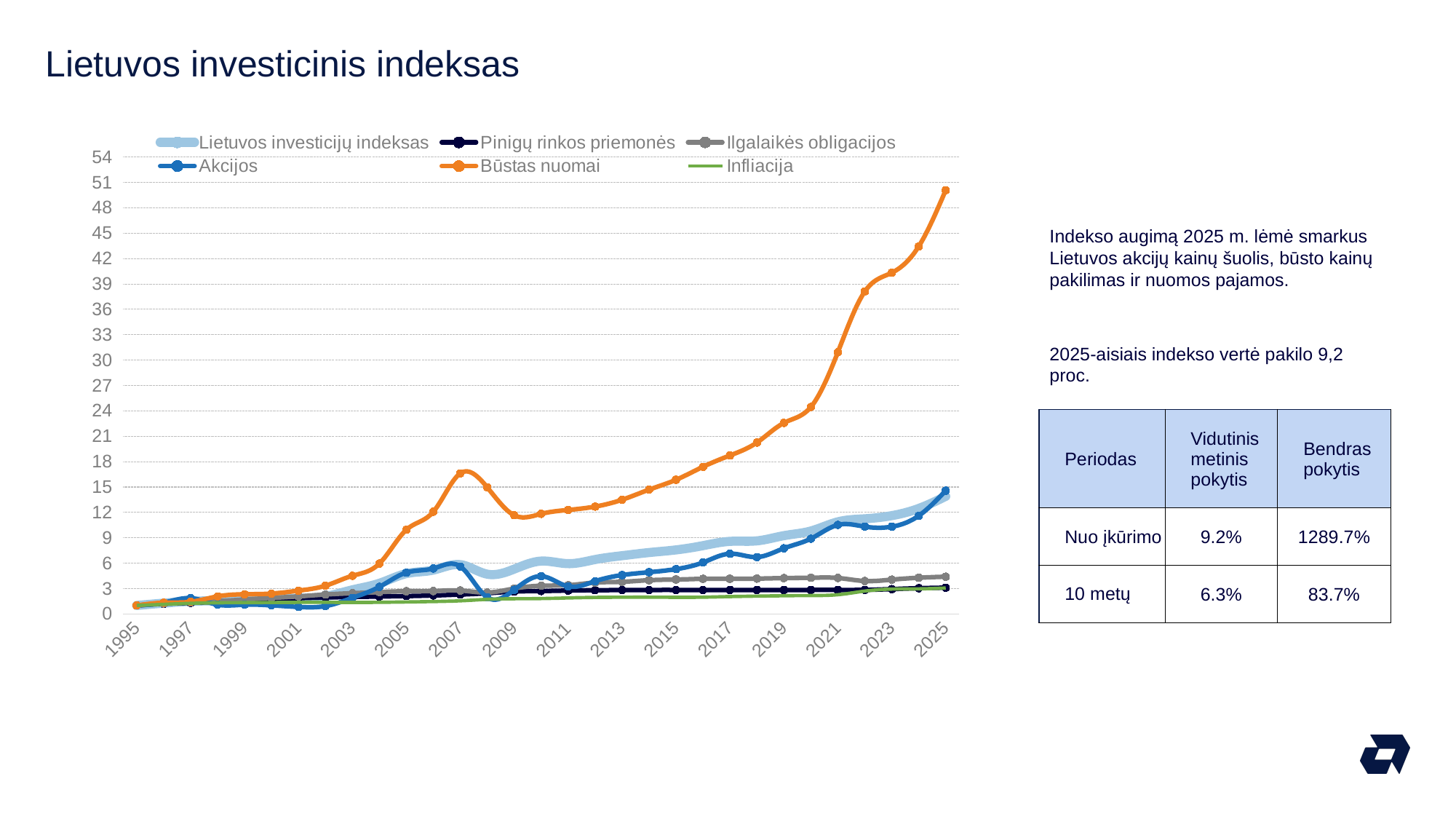
Does the Būstas nuomai series rise or fall between 2019 and 2025? rise Is the value for Lietuvos investicijų indeksas in 2025 greater or less than 12? greater How many series does the chart legend list? 6 Is the value for Būstas nuomai in 2007 greater or less than 15? greater How many year labels are shown on the x axis? 16 In 2025, which is larger: Būstas nuomai or Akcijos? Būstas nuomai Which colour is used for the Būstas nuomai series? orange What kind of chart is shown on the slide? line chart Is the value for Infliacija in 2025 greater or less than 6? less Which series has the highest value in 2025? Būstas nuomai